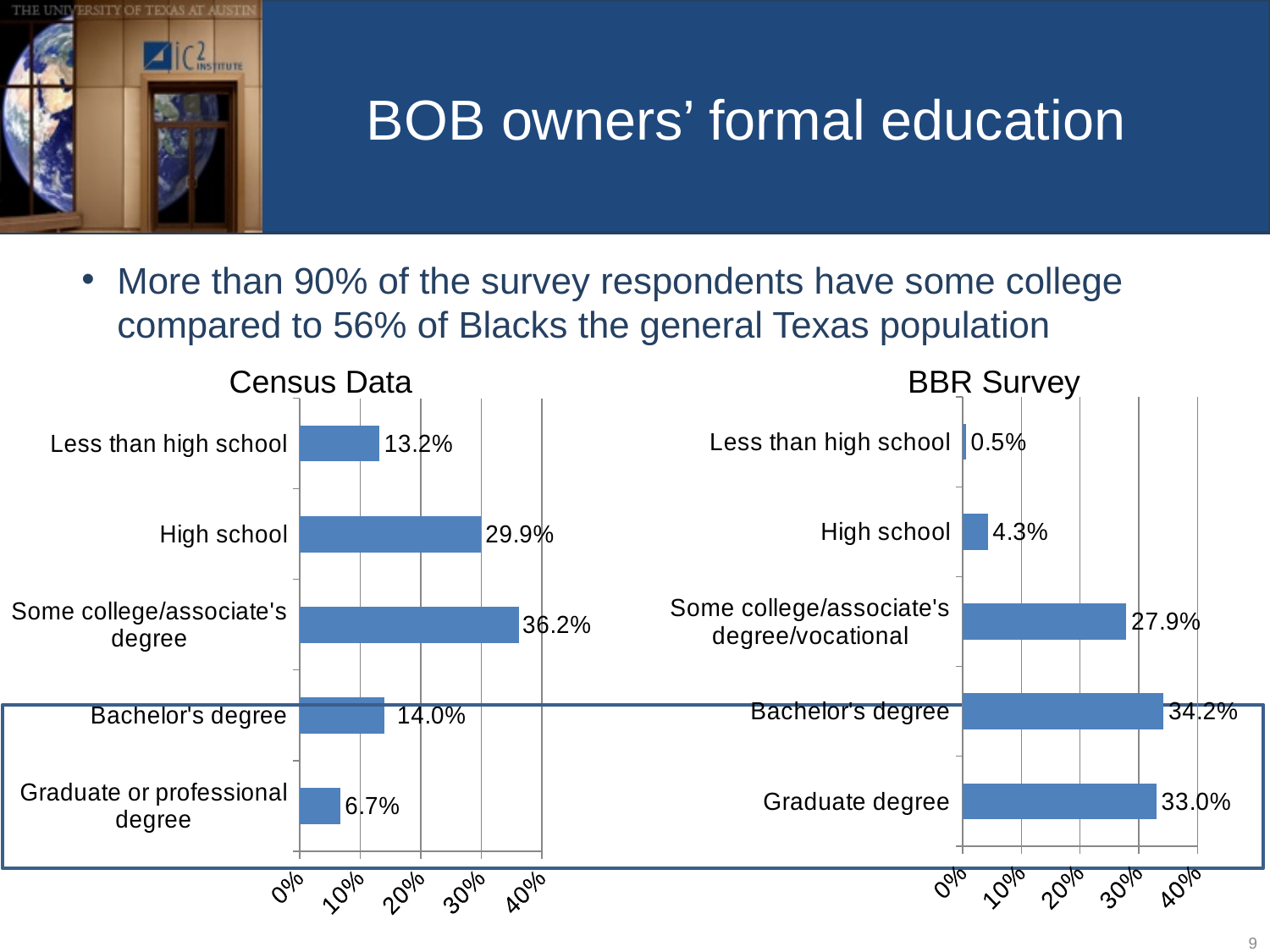
In the Census Data chart, what is the difference between Some college/associate's degree and Less than high school? 23.0% In the BBR Survey chart, is the value for High school greater or less than 10%? less What type of chart is the Census Data chart? Bar chart How many categories does the BBR Survey chart show? 5 In the Census Data chart, which category has the highest value? Some college/associate's degree In the BBR Survey chart, what is the value for Less than high school? 0.5% In the BBR Survey chart, which category has the lowest value? Less than high school In the BBR Survey chart, what is the difference between Bachelor's degree and Some college/associate's degree/vocational? 6.3% In the Census Data chart, what is the value for High school? 29.9% In the Census Data chart, which is larger: Bachelor's degree or Less than high school? Bachelor's degree In the BBR Survey chart, what is the value for Graduate degree? 33.0% In the Census Data chart, which category has the lowest value? Graduate or professional degree